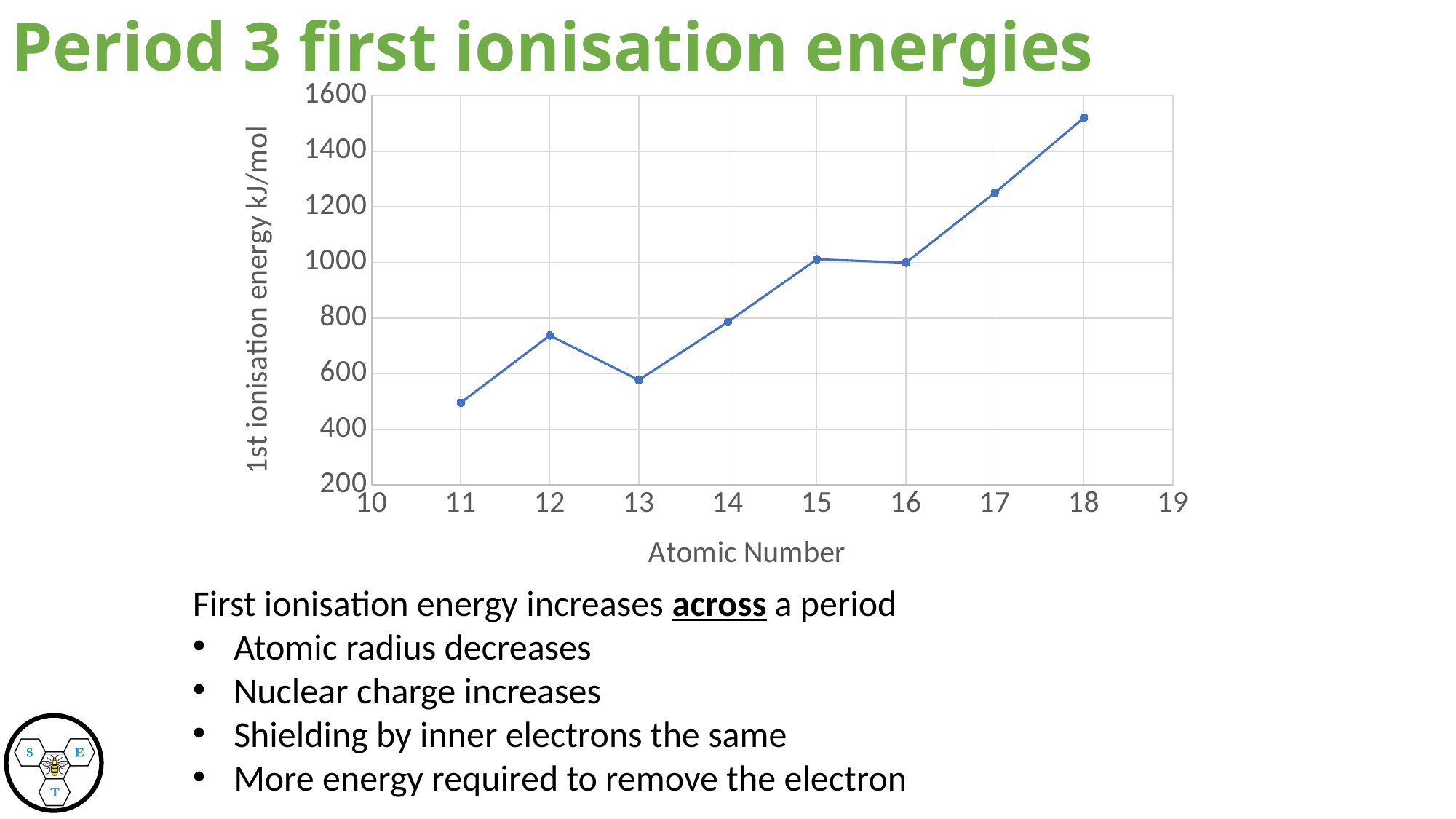
What is the label on the x axis of the chart? Atomic Number Is the value for atomic number 11 greater or less than 600? less Which atomic number has the highest first ionisation energy on the chart? 18 Which atomic number has the lowest first ionisation energy on the chart? 11 Which has the higher first ionisation energy, atomic number 14 or atomic number 17? 17 Overall, do the values rise or fall as atomic number increases from 11 to 18? rise Which has the higher first ionisation energy, atomic number 12 or atomic number 13? 12 How many data points are plotted on the chart? 8 Is the value for atomic number 18 greater or less than 1400? greater What kind of chart is shown on the slide? line chart Is the value for atomic number 17 greater or less than 1200? greater